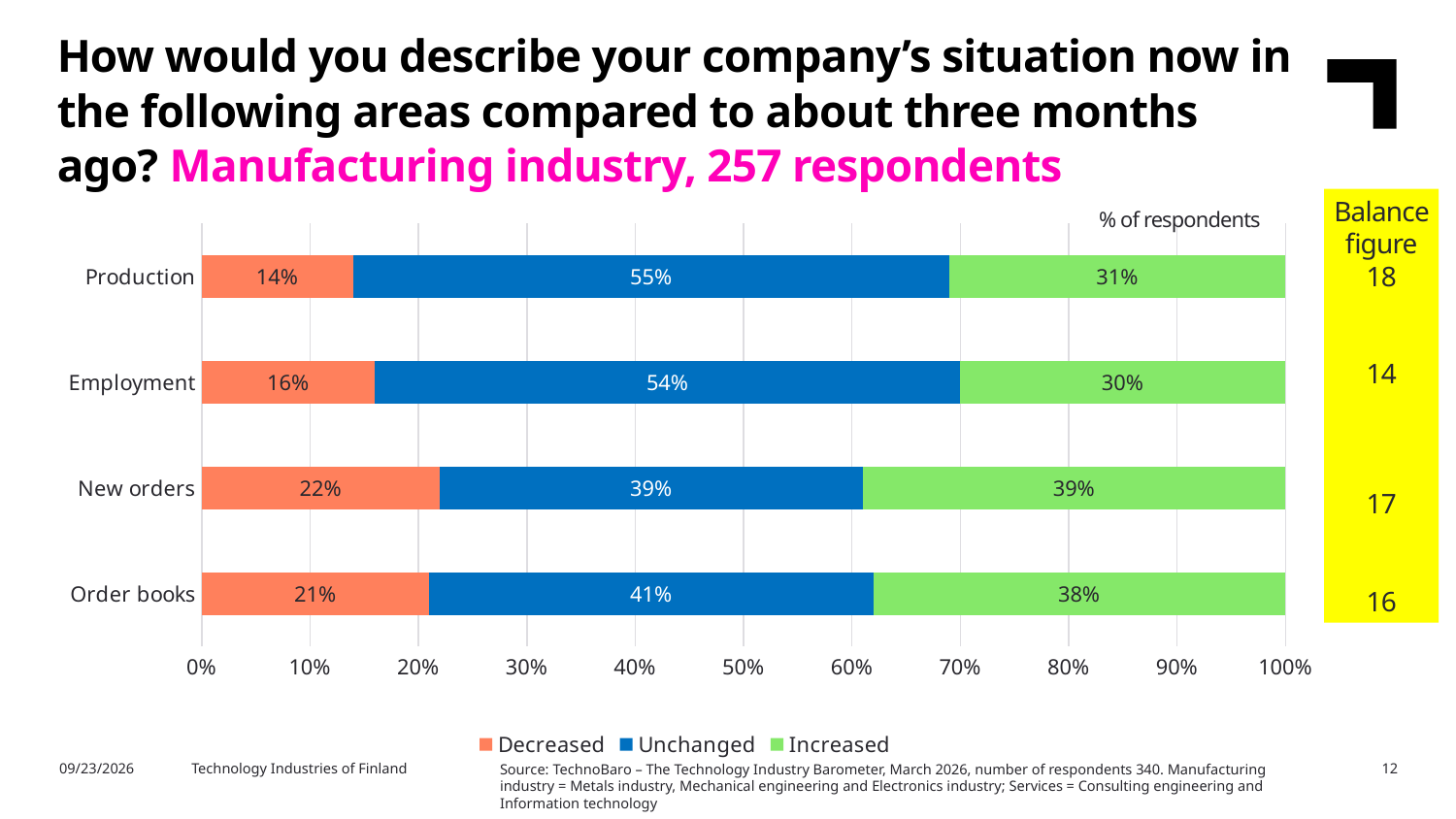
What is the total of the three segments in the Employment bar? 100% What kind of chart is shown on the slide? Stacked bar chart What is the difference between the Unchanged share for Production and the Unchanged share for New orders? 16 percentage points Which colour represents the Increased series in the legend? Green Which is larger: the Increased share for Employment or the Increased share for Order books? Order books Which category has the lowest share of respondents reporting a decrease? Production How many series does the legend list? 3 What percentage of respondents reported that New orders increased? 39% What percentage of respondents reported that Production was unchanged? 55% How many categories are shown on the chart? 4 What percentage of respondents reported that Order books decreased? 21% Which category has the highest share of respondents reporting a decrease? New orders